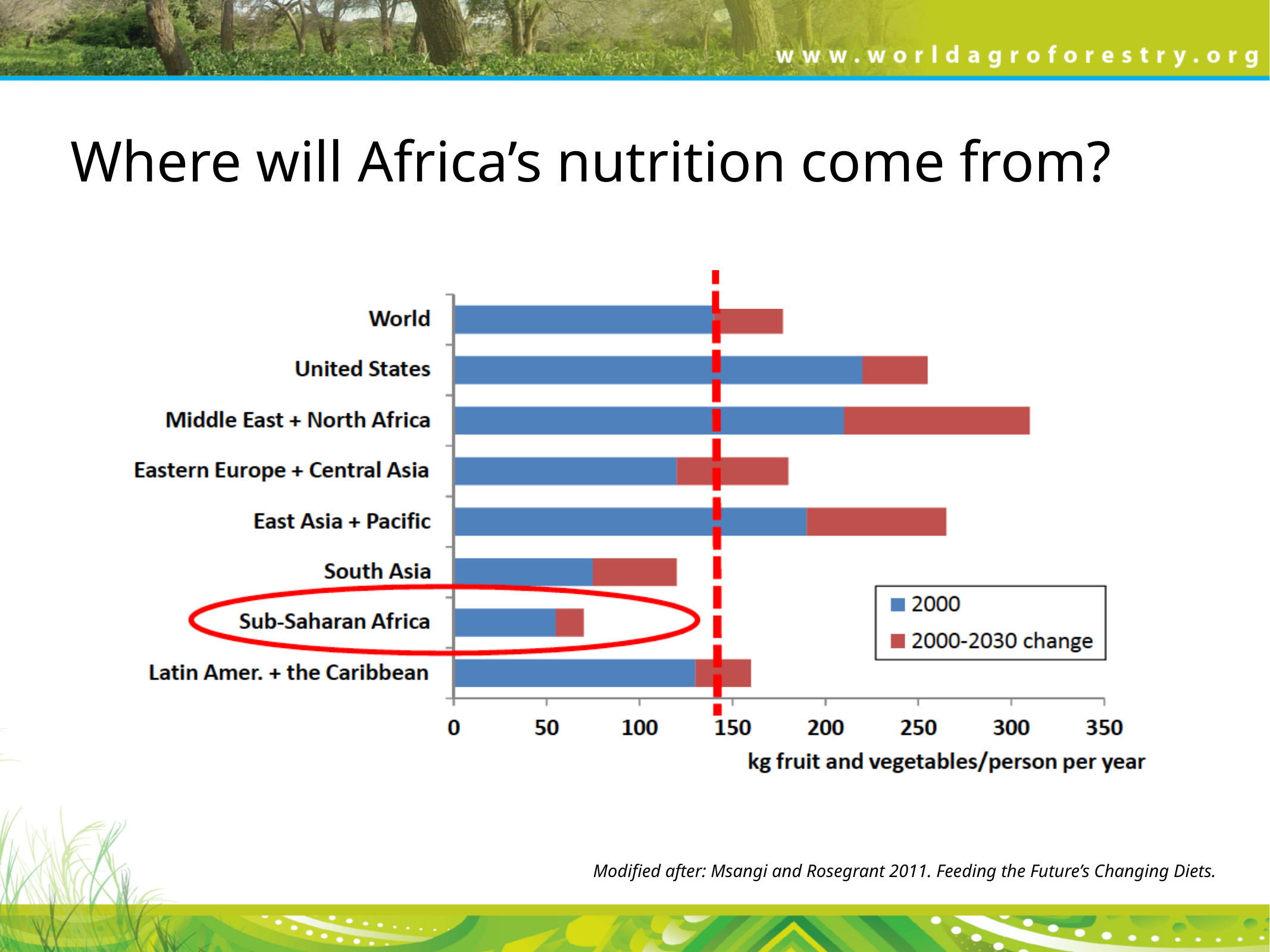
How many series does the legend list? 2 What is the label on the x axis? kg fruit and vegetables/person per year What kind of chart is shown on the slide? bar chart Is the 2000 value for United States greater or less than 200? greater Which category has the longest total bar (2000 plus 2000-2030 change)? Middle East + North Africa How many regions/categories are plotted on the chart? 8 Is the total bar for Middle East + North Africa greater or less than 300? greater Which category has the shortest total bar? Sub-Saharan Africa Which category has the lowest 2000 value? Sub-Saharan Africa Is the total bar for South Asia greater or less than 150? less Which has the larger 2000-2030 change, Middle East + North Africa or United States? Middle East + North Africa